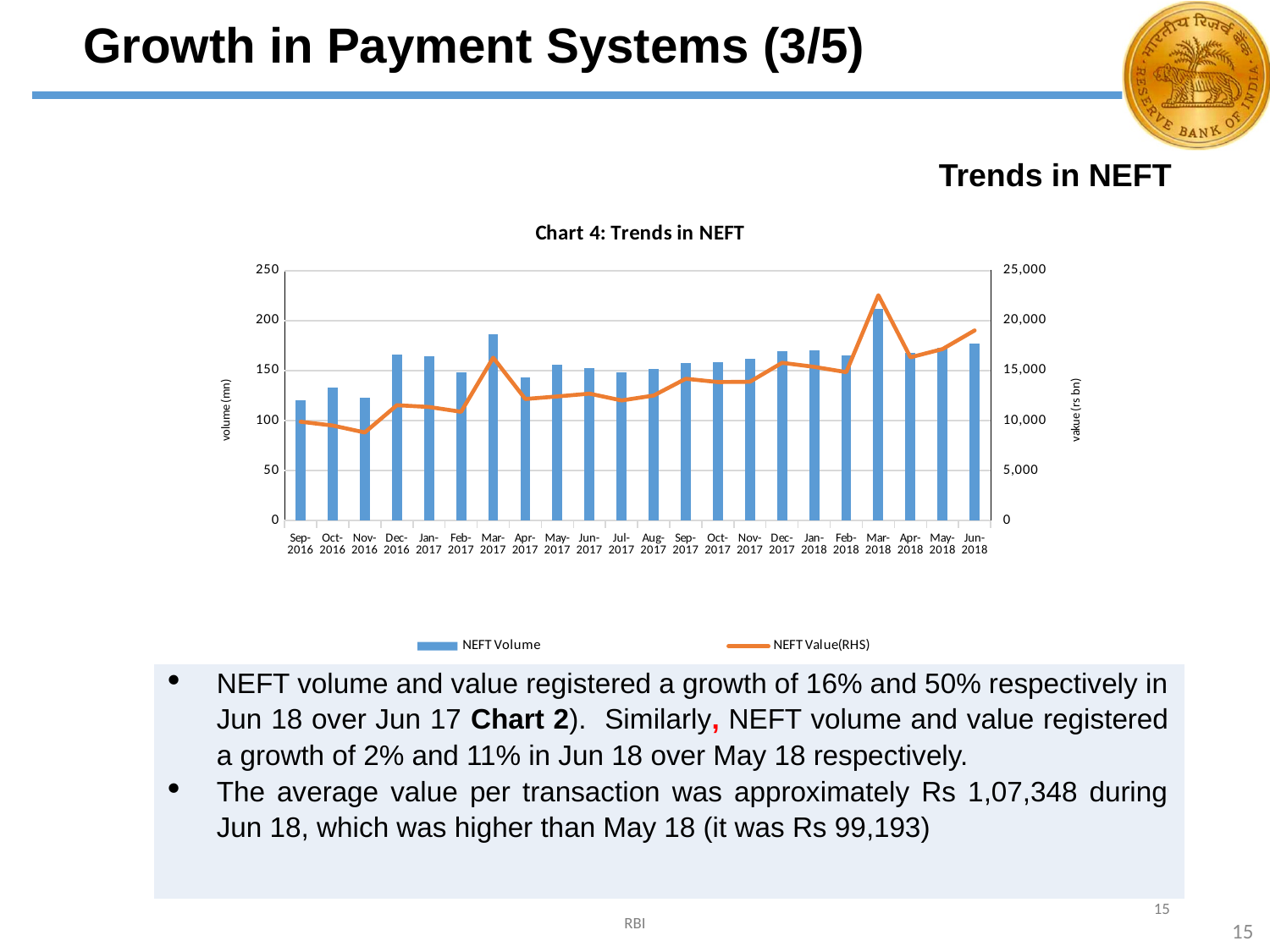
What kind of chart is used to show NEFT Volume? bar chart Which month has the larger NEFT Volume, Mar-2017 or Apr-2017? Mar-2017 How many months are shown along the x axis of the chart? 22 In which month is NEFT Volume highest? Mar-2018 Overall, does NEFT Volume rise or fall from Sep-2016 to Jun-2018? rise In which month is NEFT Value(RHS) highest? Mar-2018 Is the NEFT Volume for Mar-2018 greater or less than 200? greater What is the title of the chart on the slide? Chart 4: Trends in NEFT What are the two series named in the chart's legend? NEFT Volume and NEFT Value(RHS) In which month is NEFT Value(RHS) lowest? Nov-2016 Is the NEFT Value(RHS) for Nov-2016 greater or less than 10,000? less How many series does the chart's legend list? 2